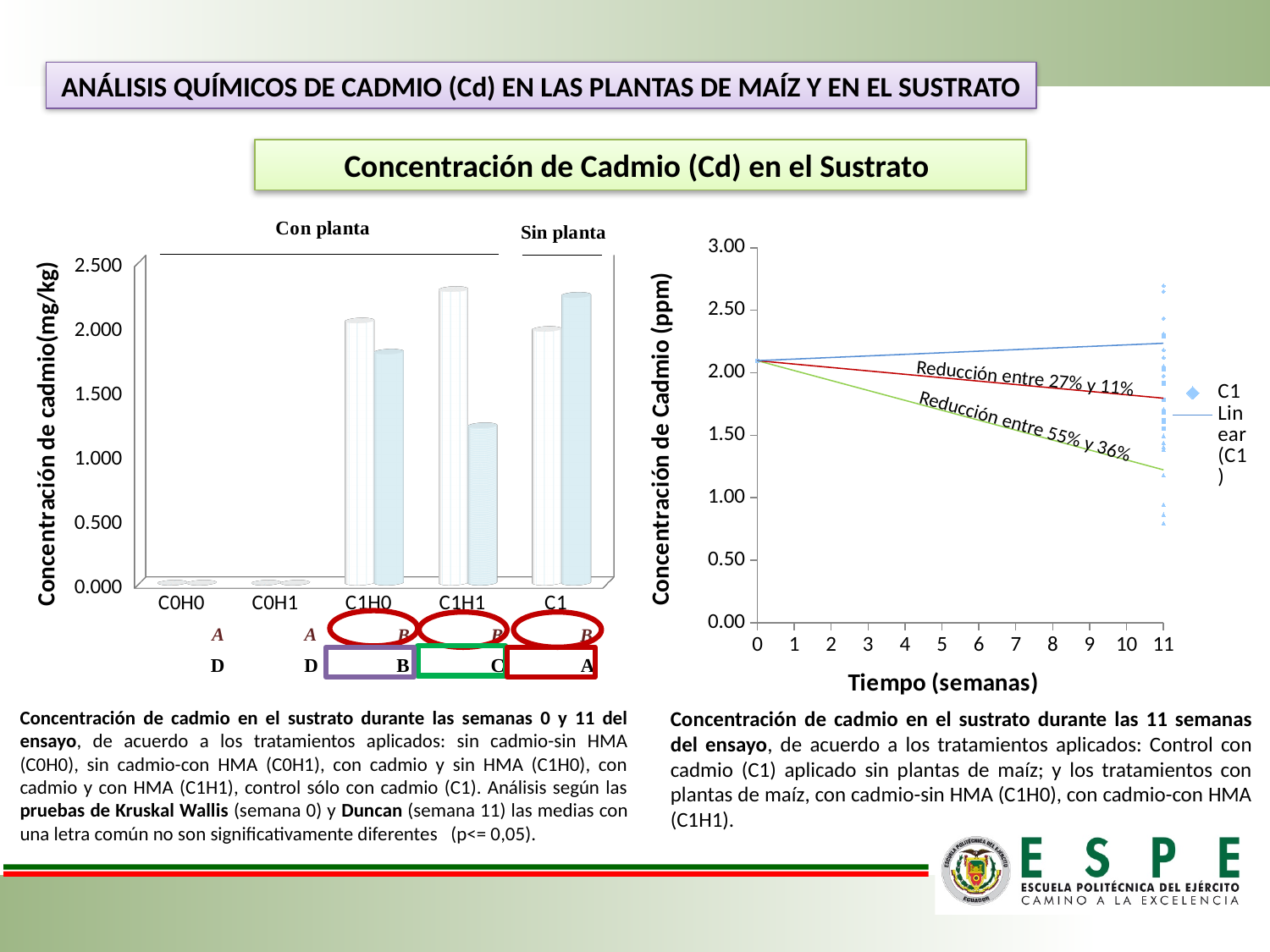
What kind of chart is the left chart, 'Concentración de cadmio(mg/kg)' by treatment? bar chart What is the highest tick value shown on the y axis of the right chart? 3.00 How many treatment categories are shown on the x axis of the left bar chart? 5 In the left bar chart, which of the two bars for C1H1 is larger, the first (left) bar or the second (right) bar? the first (left) bar What is the x-axis title of the right chart? Tiempo (semanas) In the left bar chart, is the value of the first (left) bar for C1H1 greater or less than 2.000? greater In the left bar chart, which categories have bars at essentially 0.000? C0H0 and C0H1 In the left bar chart, is the value of the second (right) bar for C1H0 greater or less than 1.500? greater In the right chart, does the blue trend line rise or fall from week 0 to week 11? rise How many entries does the legend of the right chart list? 2 In the left bar chart, is the value of the second (right) bar for C1H1 greater or less than 1.500? less In the right chart, does the green trend line rise or fall from week 0 to week 11? fall